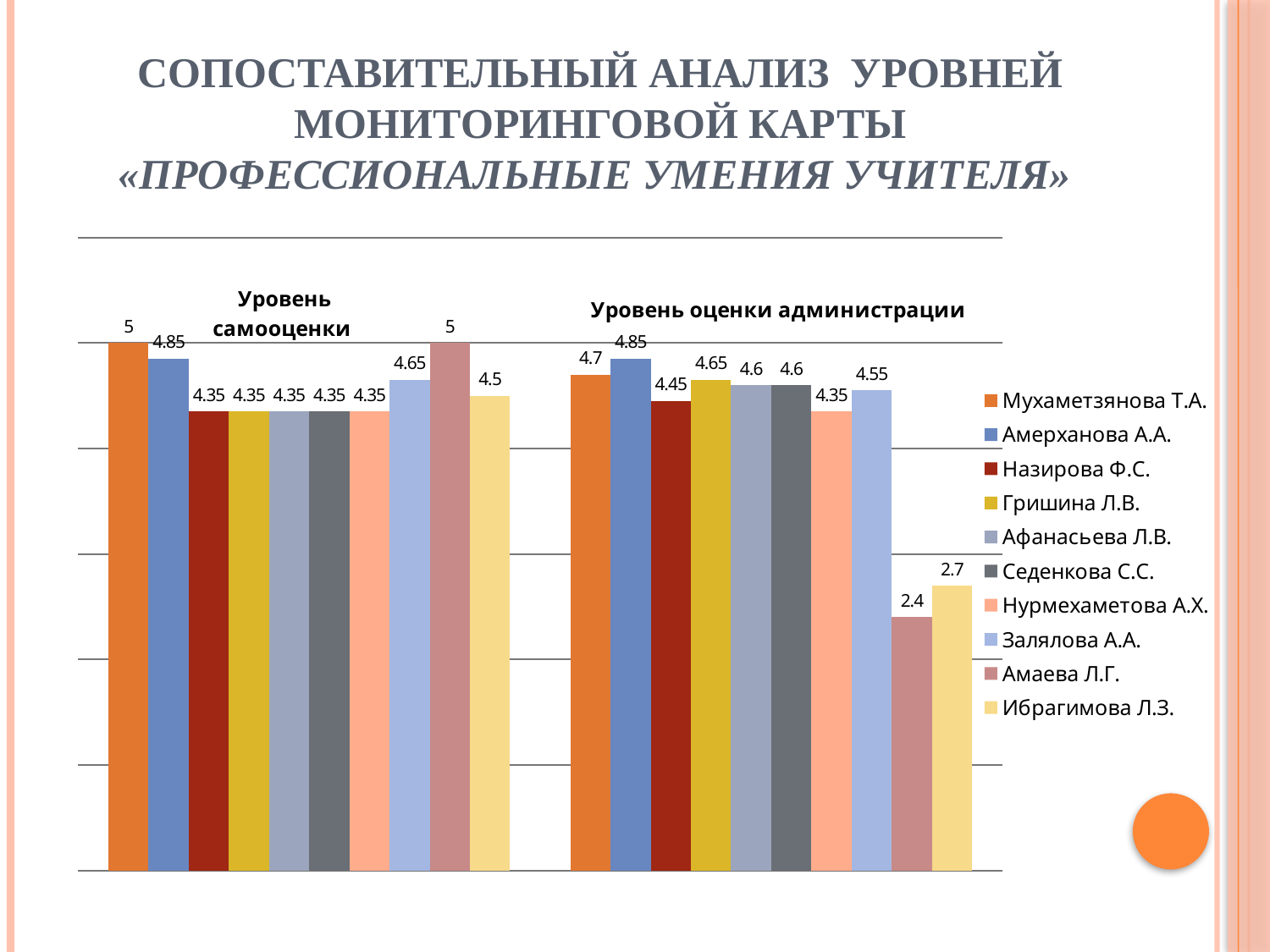
What is the difference between the Уровень самооценки and Уровень оценки администрации values for Амаева Л.Г.? 2.6 What is the value for Ибрагимова Л.З. in the Уровень оценки администрации category? 2.7 What is the value for Гришина Л.В. in the Уровень оценки администрации category? 4.65 What is the value for Залялова А.А. in the Уровень самооценки category? 4.65 How many series does the legend list? 10 What is the difference between the Уровень самооценки and Уровень оценки администрации values for Мухаметзянова Т.А.? 0.3 What kind of chart is shown on the slide? Bar chart What is the value for Мухаметзянова Т.А. in the Уровень самооценки category? 5 Which series has the lowest value in the Уровень оценки администрации category? Амаева Л.Г. What is the value for Амаева Л.Г. in the Уровень оценки администрации category? 2.4 How many categories are shown on the x axis? 2 Which is larger for Ибрагимова Л.З.: the Уровень самооценки value or the Уровень оценки администрации value? Уровень самооценки